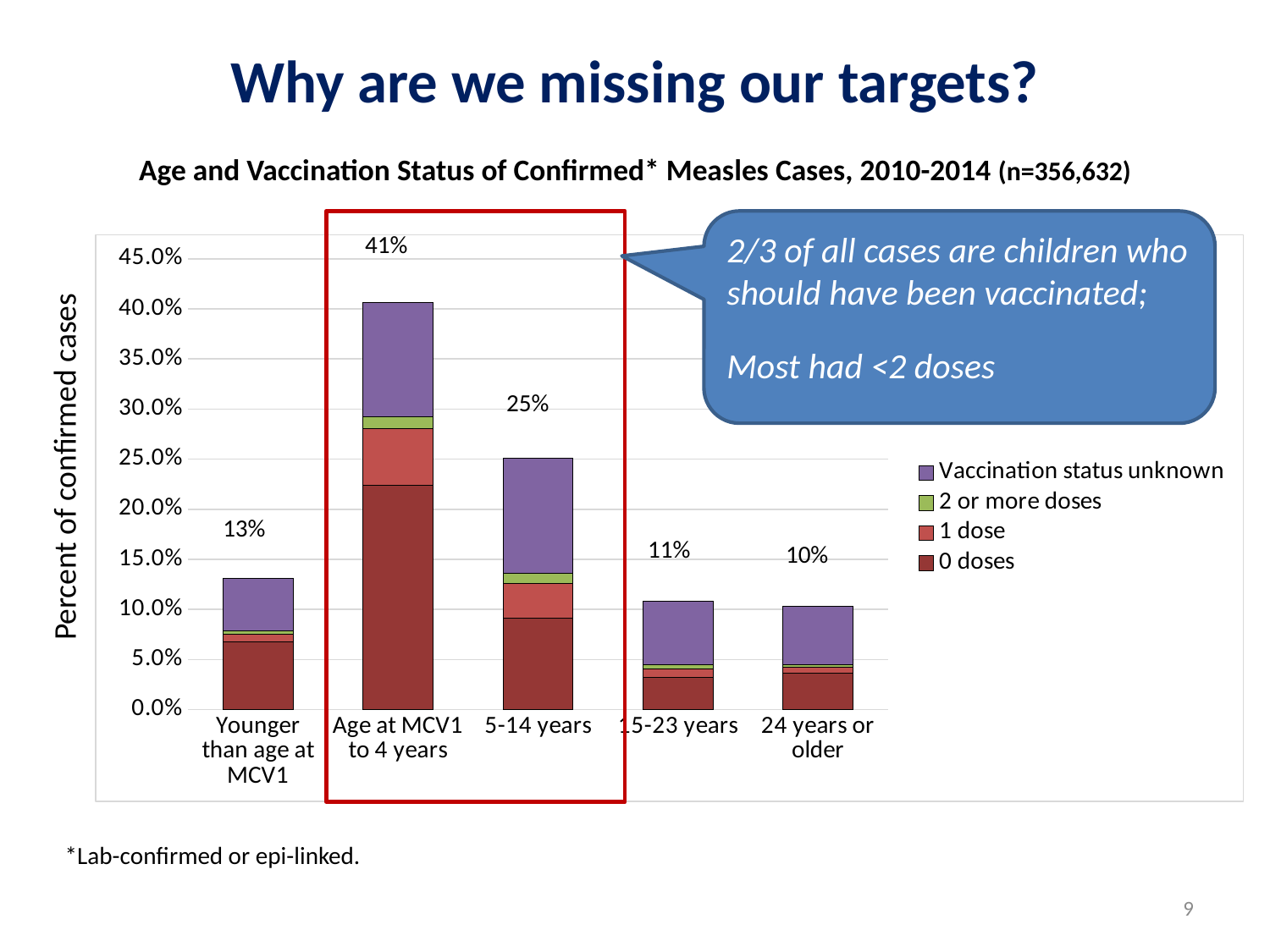
What is the difference between the total percentage for 'Age at MCV1 to 4 years' and '5-14 years'? 16% Which has a larger total percentage of confirmed cases: '15-23 years' or 'Younger than age at MCV1'? Younger than age at MCV1 What kind of chart is shown on the slide? Stacked bar chart How many age groups are shown on the x axis? 5 What is the total percentage of confirmed cases for the 'Age at MCV1 to 4 years' group? 41% Which age group has the highest total percentage of confirmed cases? Age at MCV1 to 4 years How many series does the legend list? 4 Is the '0 doses' value for the 'Age at MCV1 to 4 years' group greater or less than 20.0%? greater What is the total percentage of confirmed cases for the '5-14 years' group? 25% What is the label of the y axis? Percent of confirmed cases Which age group has the lowest total percentage of confirmed cases? 24 years or older What is the total percentage of confirmed cases for the 'Younger than age at MCV1' group? 13%